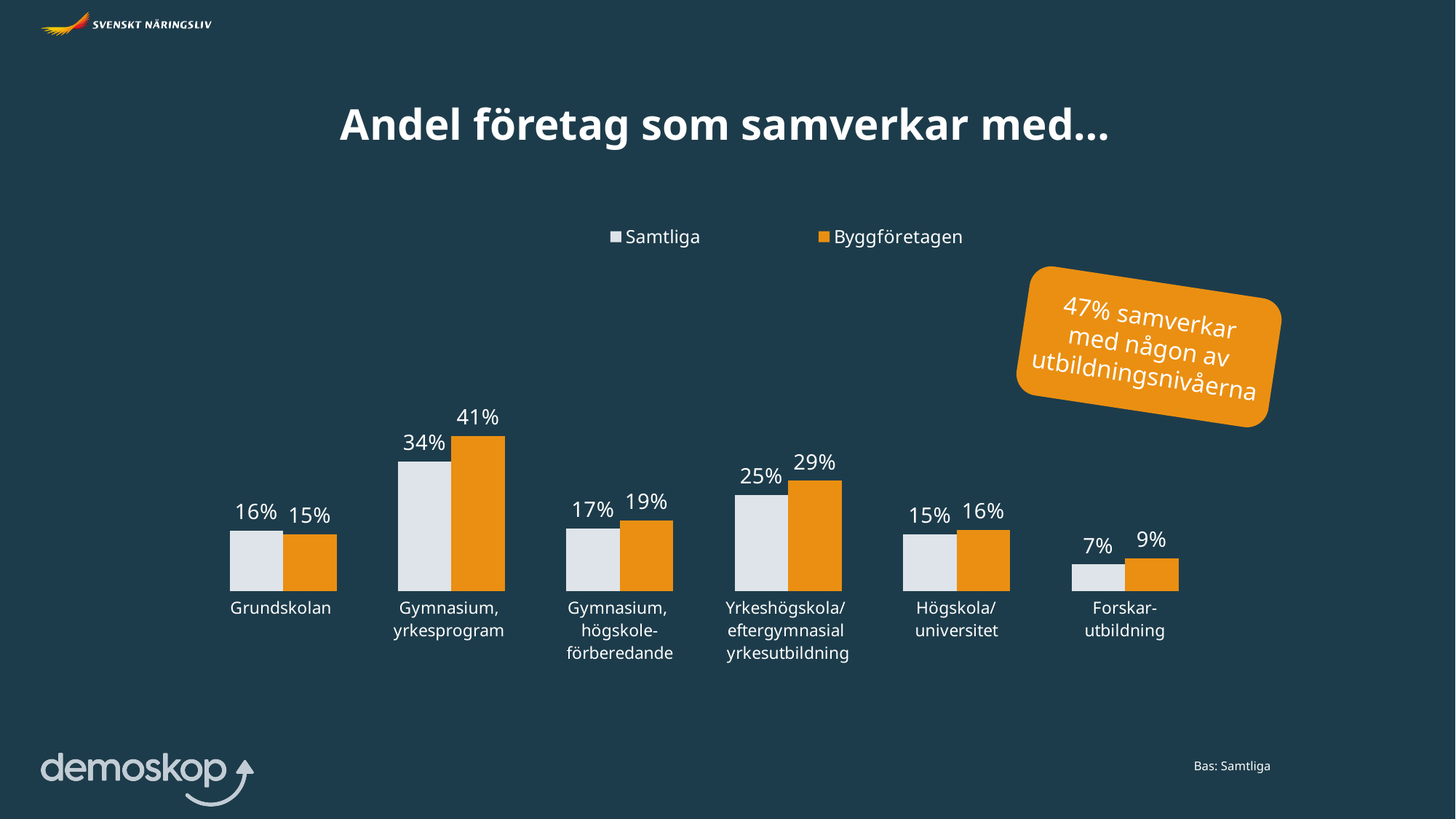
Which colour represents the Byggföretagen series? Orange What is the difference between Byggföretagen and Samtliga in the Gymnasium, yrkesprogram category? 7 percentage points How many categories are shown on the x axis? 6 Which category has the lowest value for Byggföretagen? Forskarutbildning Which category has the highest value for Samtliga? Gymnasium, yrkesprogram What is the value for Samtliga in the Forskarutbildning category? 7% How many series does the legend list? 2 What is the value for Byggföretagen in the Gymnasium, yrkesprogram category? 41% What kind of chart is shown on the slide? Bar chart In the Grundskolan category, which series has the larger value, Samtliga or Byggföretagen? Samtliga What is the value for Samtliga in the Yrkeshögskola/eftergymnasial yrkesutbildning category? 25% What is the title of the chart? Andel företag som samverkar med…